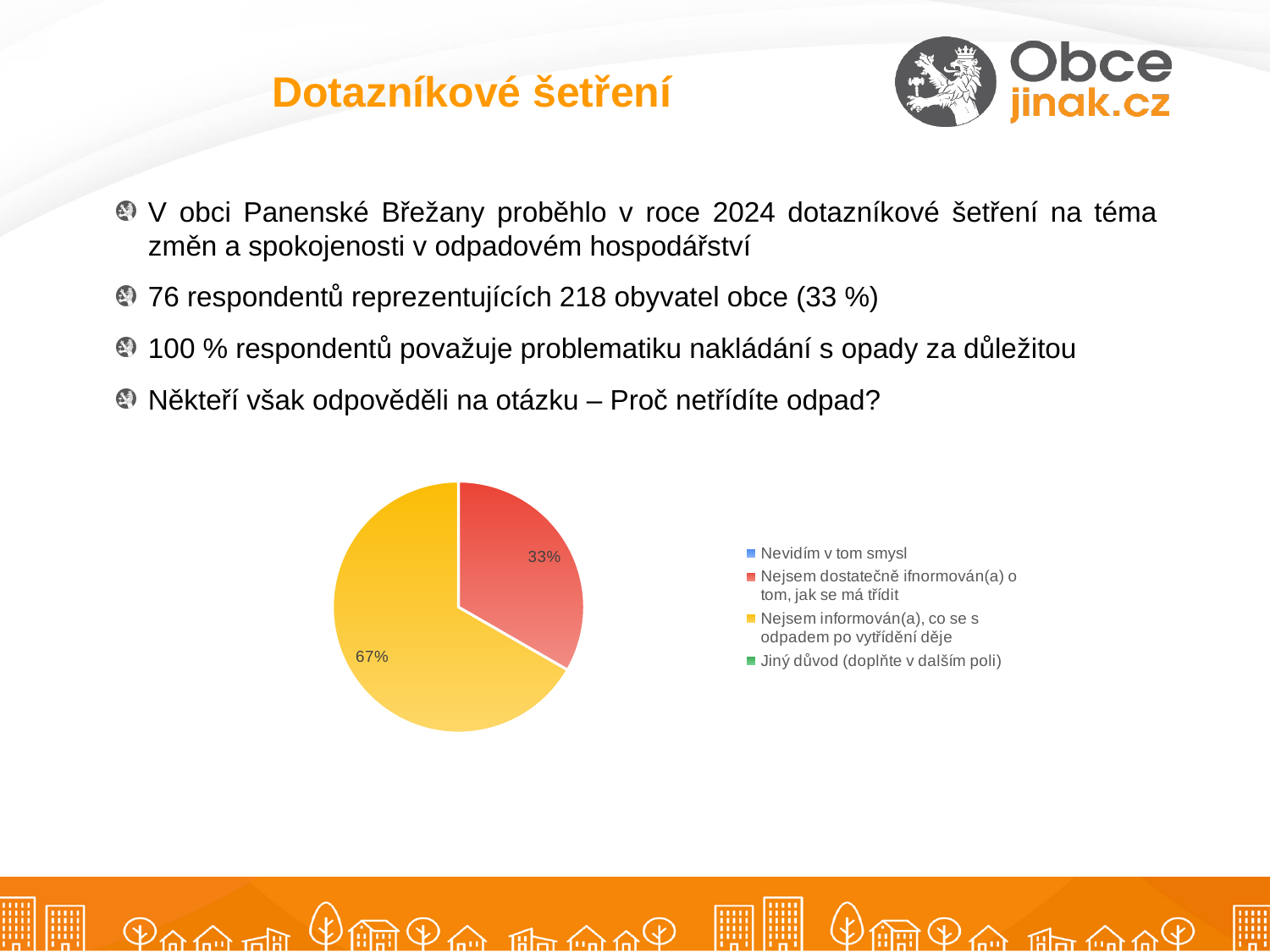
Which legend category has the largest slice of the pie? Nejsem informován(a), co se s odpadem po vytřídění děje What is the total of the two labelled slices in the pie chart? 100% How many entries does the legend of the pie chart list? 4 Is the share of the slice "Nejsem informován(a), co se s odpadem po vytřídění děje" greater or less than 50%? greater What colour is the slice labelled 33%? red How many slices with data labels are visible in the pie chart? 2 What share of the pie does the slice "Nejsem dostatečně ifnormován(a) o tom, jak se má třídit" represent? 33% What is the difference in percentage points between the 67% slice and the 33% slice? 34 Which of the two visible slices is larger: the red one or the yellow one? the yellow one What share of the pie does the slice "Nejsem informován(a), co se s odpadem po vytřídění děje" represent? 67% What colour is the slice labelled 67%? yellow What kind of chart is shown on the slide? pie chart